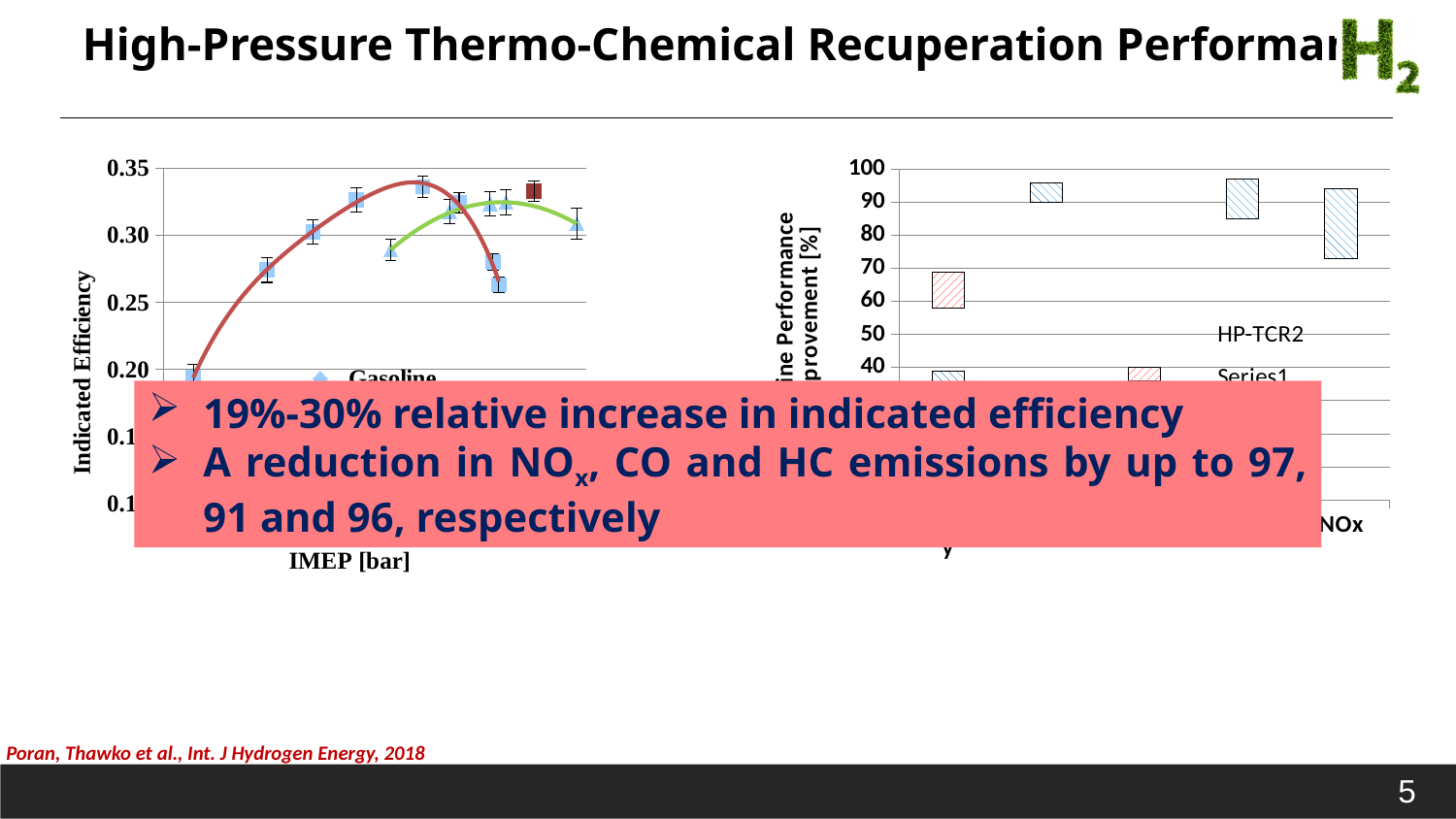
On the left chart, is the highest plotted point greater or less than 0.35? less On the left chart, what is the label of the x axis? IMEP [bar] On the left chart, what is the label of the y axis? Indicated Efficiency On the left chart, is the peak of the red fitted curve greater or less than 0.30? greater On the right chart, is the top of the leftmost red hatched bar greater or less than 80? less On the right chart, what is the highest value shown on the y axis? 100 What kind of chart is the left chart (Indicated Efficiency vs IMEP)? scatter chart with fitted curves